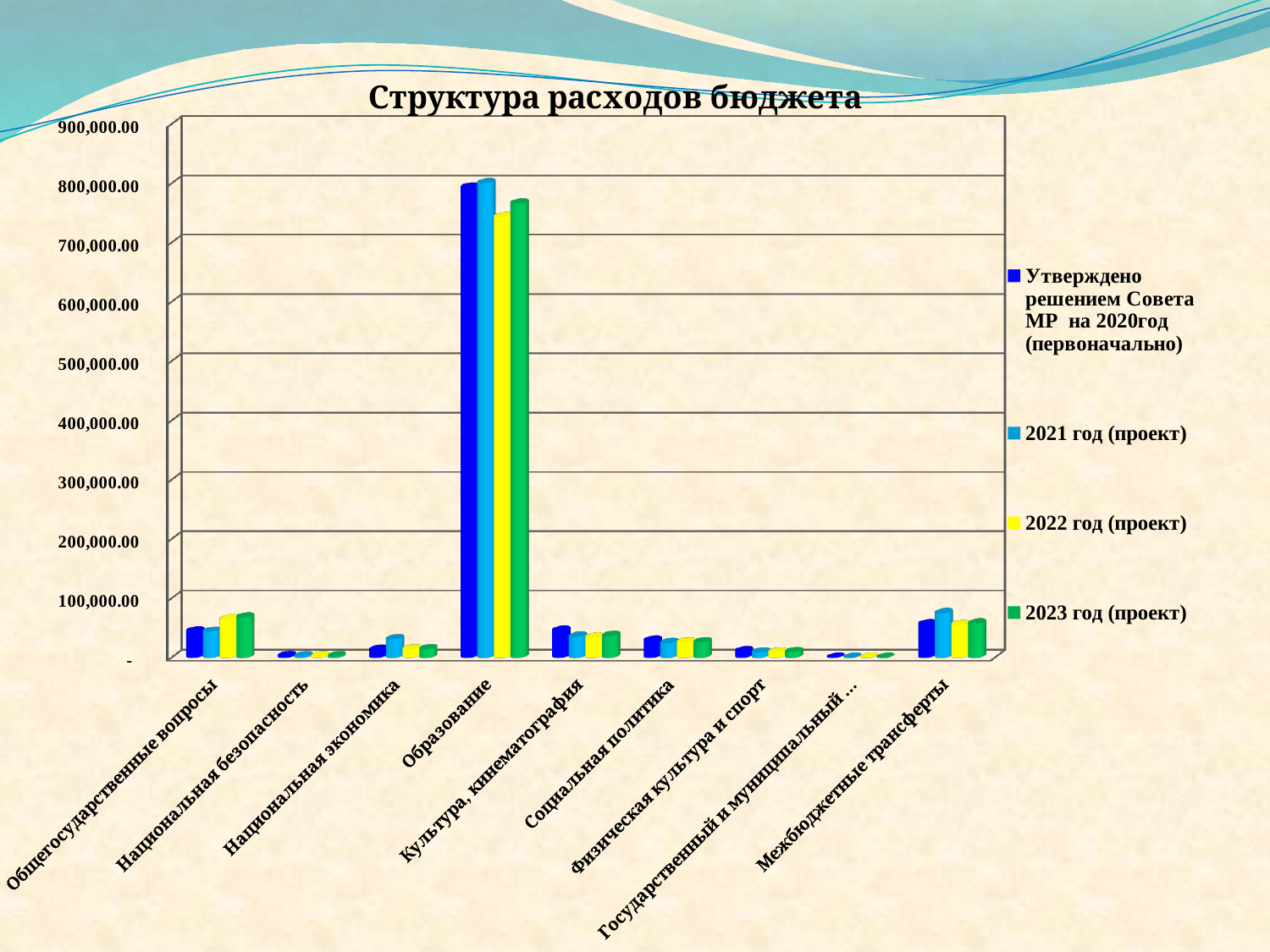
Which category has the highest values in the chart? Образование How many series does the legend list? 4 Is the value for Общегосударственные вопросы in the series 2023 год (проект) greater or less than 100,000.00? less Is the value for Образование in the series 2022 год (проект) greater or less than 800,000.00? less How many categories are shown on the x axis of the chart? 9 Which is larger for the series 2021 год (проект): Образование or Межбюджетные трансферты? Образование Which series is shown in yellow in the legend? 2022 год (проект) Which is larger for the series 2023 год (проект): Общегосударственные вопросы or Национальная безопасность? Общегосударственные вопросы What is the title of the chart? Структура расходов бюджета Is the value for Социальная политика in the series Утверждено решением Совета МР на 2020год (первоначально) greater or less than 100,000.00? less What kind of chart is shown on the slide? bar chart